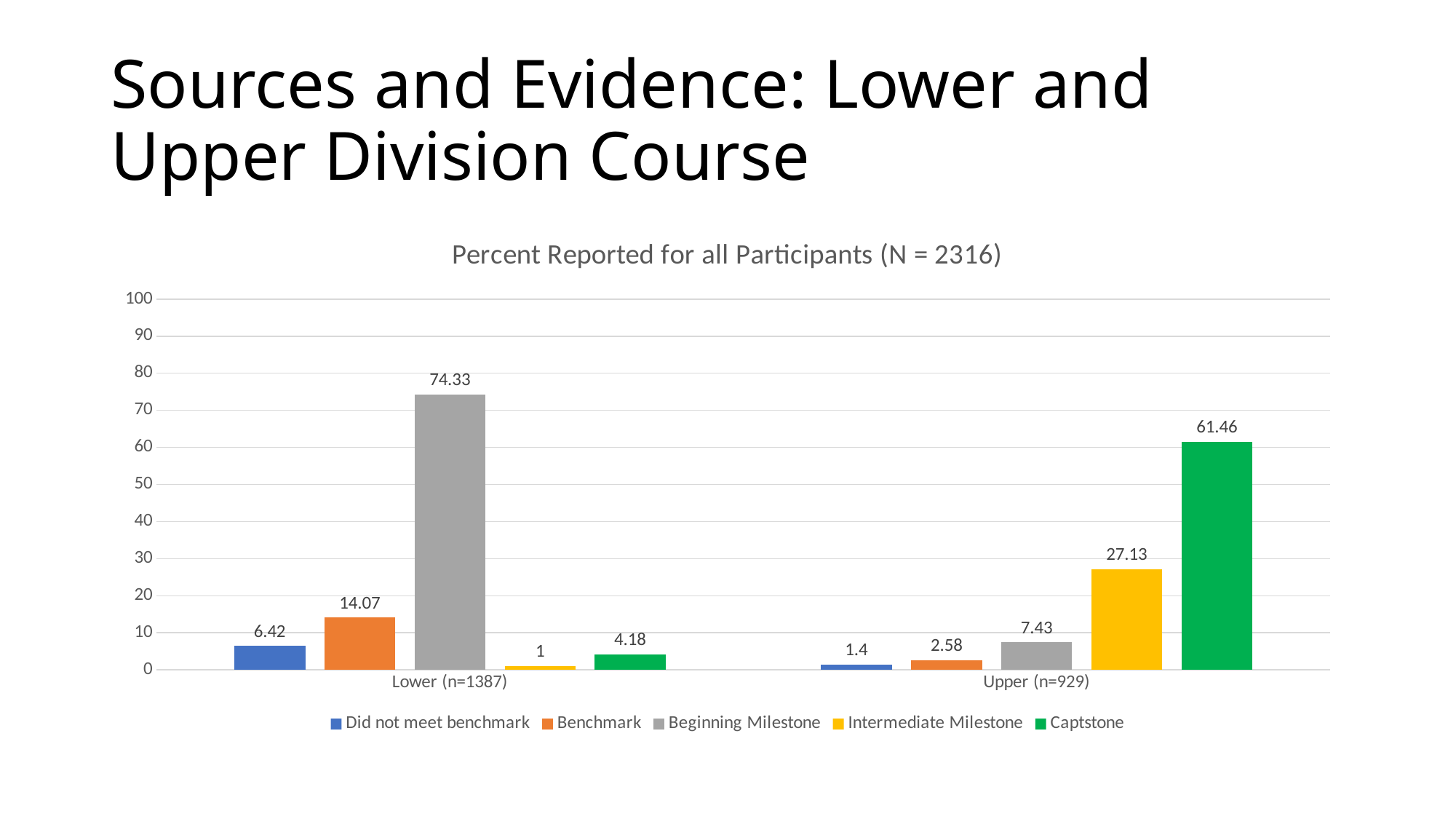
What is the value for Captstone in the Upper (n=929) category? 61.46 What is the title of the chart? Percent Reported for all Participants (N = 2316) What is the value for Intermediate Milestone in the Lower (n=1387) category? 1 What is the value for Benchmark in the Upper (n=929) category? 2.58 How many categories are shown on the x axis? 2 What is the value for Beginning Milestone in the Lower (n=1387) category? 74.33 What is the difference between the Intermediate Milestone values for Upper (n=929) and Lower (n=1387)? 26.13 Which series has the lowest value in the Upper (n=929) category? Did not meet benchmark Which is larger: Benchmark for Lower (n=1387) or Beginning Milestone for Upper (n=929)? Benchmark for Lower (n=1387) Which series has the highest value in the Lower (n=1387) category? Beginning Milestone What kind of chart is shown on the slide? Bar chart How many series does the legend list? 5